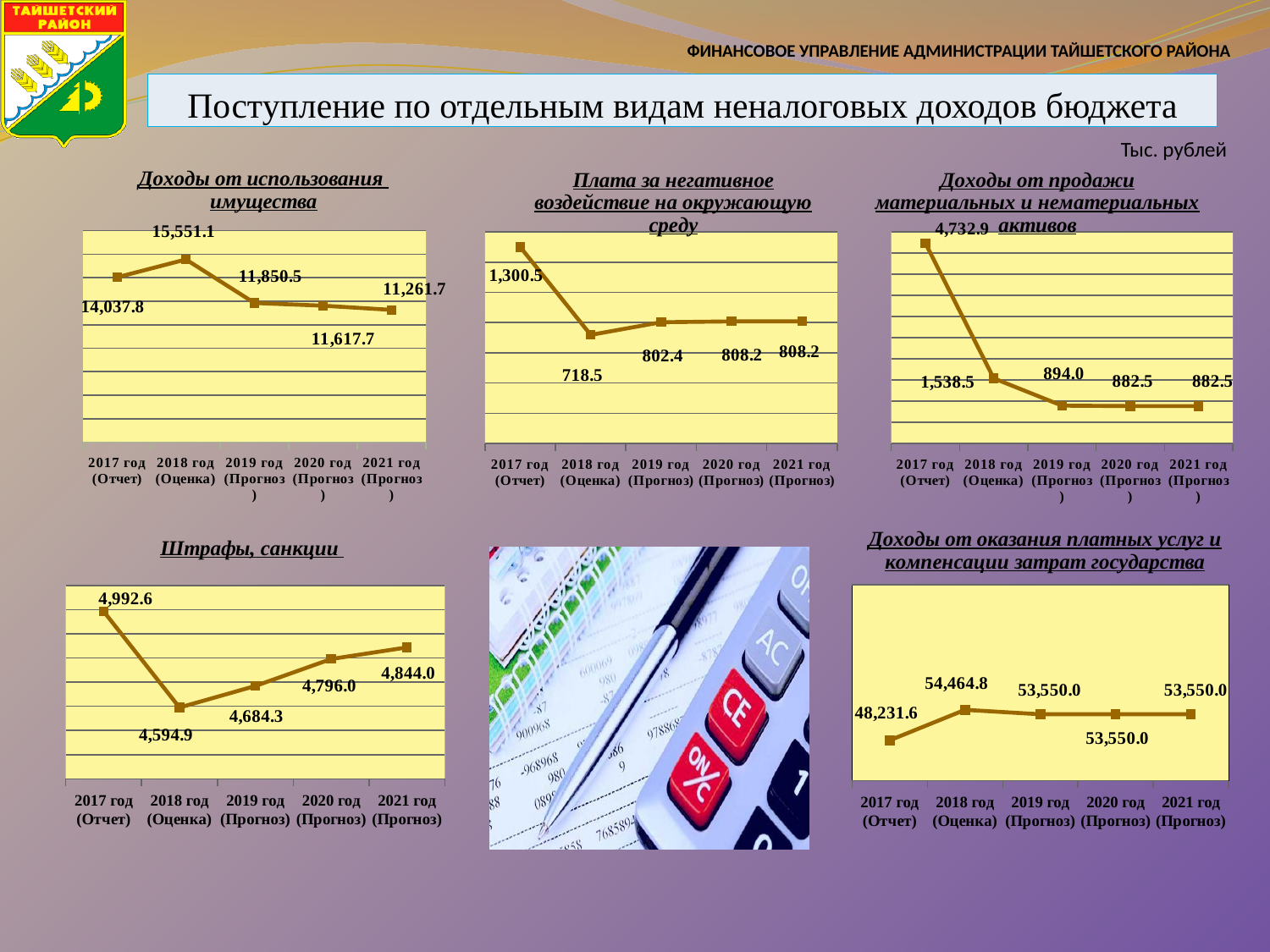
In the chart 'Плата за негативное воздействие на окружающую среду', what is the value for 2017 год (Отчет)? 1,300.5 What type of chart is 'Штрафы, санкции'? line chart In the chart 'Штрафы, санкции', what is the difference between the 2021 and 2020 values? 48.0 How many data points are plotted in the chart 'Доходы от оказания платных услуг и компенсации затрат государства'? 5 In the chart 'Штрафы, санкции', do the values rise or fall from 2018 to 2021? rise In the chart 'Доходы от продажи материальных и нематериальных активов', what is the value for 2019 год (Прогноз)? 894.0 In the chart 'Доходы от использования имущества', what is the value for 2018 год (Оценка)? 15,551.1 In the chart 'Доходы от оказания платных услуг и компенсации затрат государства', which is larger, the value for 2017 or the value for 2018? 2018 In the chart 'Доходы от продажи материальных и нематериальных активов', what is the difference between the 2017 and 2018 values? 3,194.4 In the chart 'Плата за негативное воздействие на окружающую среду', which year has the lowest value? 2018 год (Оценка) In the chart 'Штрафы, санкции', which year has the highest value? 2017 год (Отчет) In the chart 'Доходы от использования имущества', which year has the lowest value? 2021 год (Прогноз)